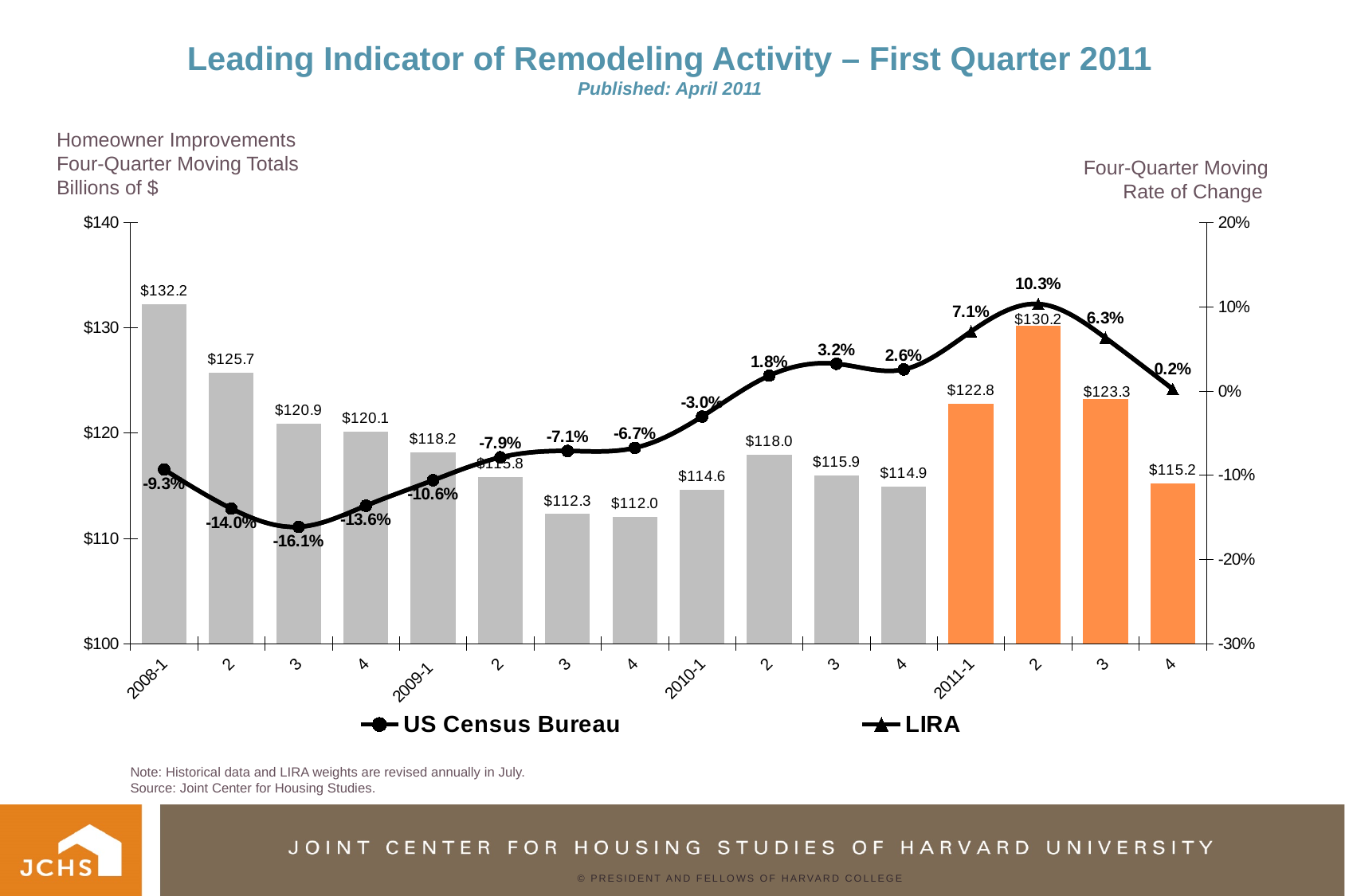
Which quarter has the highest four-quarter moving total bar? 2008-1 What is the four-quarter moving total for 2008-1? $132.2 How many series does the legend list? 2 Which quarter has the highest LIRA rate of change? 2011-2 Which quarter has the lowest four-quarter moving total bar? 2009-4 What is the lowest four-quarter moving rate of change shown on the line? -16.1% What is the difference between the four-quarter moving totals for 2011-2 and 2011-1? $7.4 What is the four-quarter moving rate of change for 2008-3? -16.1% How many quarters (bars) are plotted on the chart? 16 Which has the larger four-quarter moving total, 2010-2 or 2010-3? 2010-2 What is the title of the slide's chart? Leading Indicator of Remodeling Activity – First Quarter 2011 What is the four-quarter moving total for 2011-2? $130.2